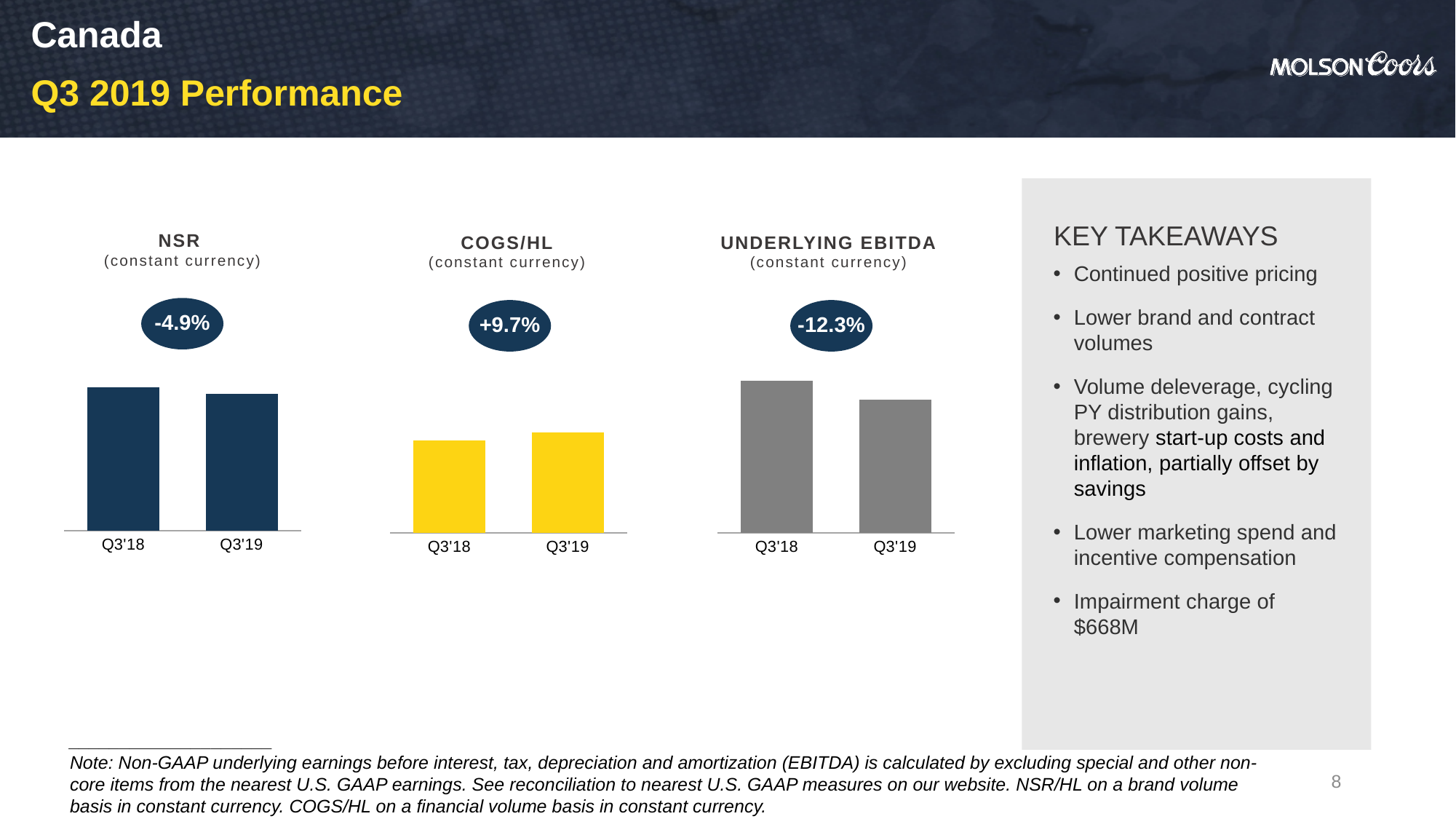
Does the value in the COGS/HL (constant currency) chart rise or fall from Q3'18 to Q3'19? rise How many bars does the COGS/HL (constant currency) chart show? 2 What colour are the bars in the COGS/HL (constant currency) chart? yellow Does the value in the Underlying EBITDA (constant currency) chart rise or fall from Q3'18 to Q3'19? fall What percentage change is shown above the NSR (constant currency) chart? -4.9% What percentage change is shown above the COGS/HL (constant currency) chart? +9.7% In the COGS/HL (constant currency) chart, which bar is taller, Q3'18 or Q3'19? Q3'19 How many bar charts are shown on the slide? 3 In the NSR (constant currency) chart, which bar is taller, Q3'18 or Q3'19? Q3'18 In the Underlying EBITDA (constant currency) chart, which period has the lower value? Q3'19 What percentage change is shown above the Underlying EBITDA (constant currency) chart? -12.3% What kind of chart is the NSR (constant currency) chart? bar chart